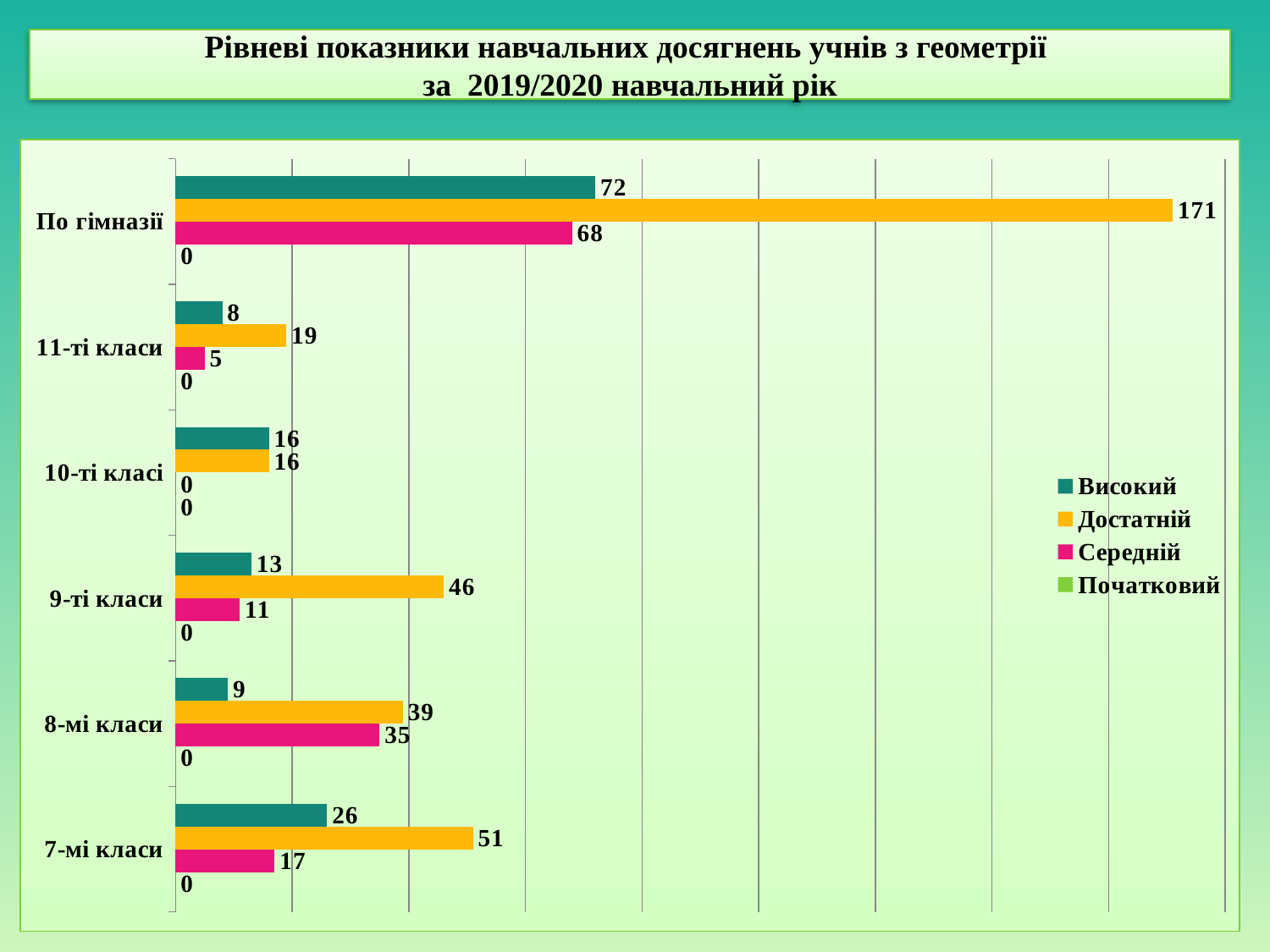
How many series does the legend list? 4 What is the value for Достатній for По гімназії? 171 What is the difference between the Достатній and Високий values for По гімназії? 99 Which series is shown in pink on the chart? Середній Which class group has the lowest Високий value? 11-ті класи What kind of chart is shown on the slide? bar chart Which is larger for 9-ті класи: Високий or Середній? Високий What is the value for Середній for 10-ті класі? 0 Which class group has the highest Достатній value (excluding По гімназії)? 7-мі класи What is the value for Середній for 8-мі класи? 35 How many class categories are shown on the chart? 6 What is the value for Високий for 7-мі класи? 26